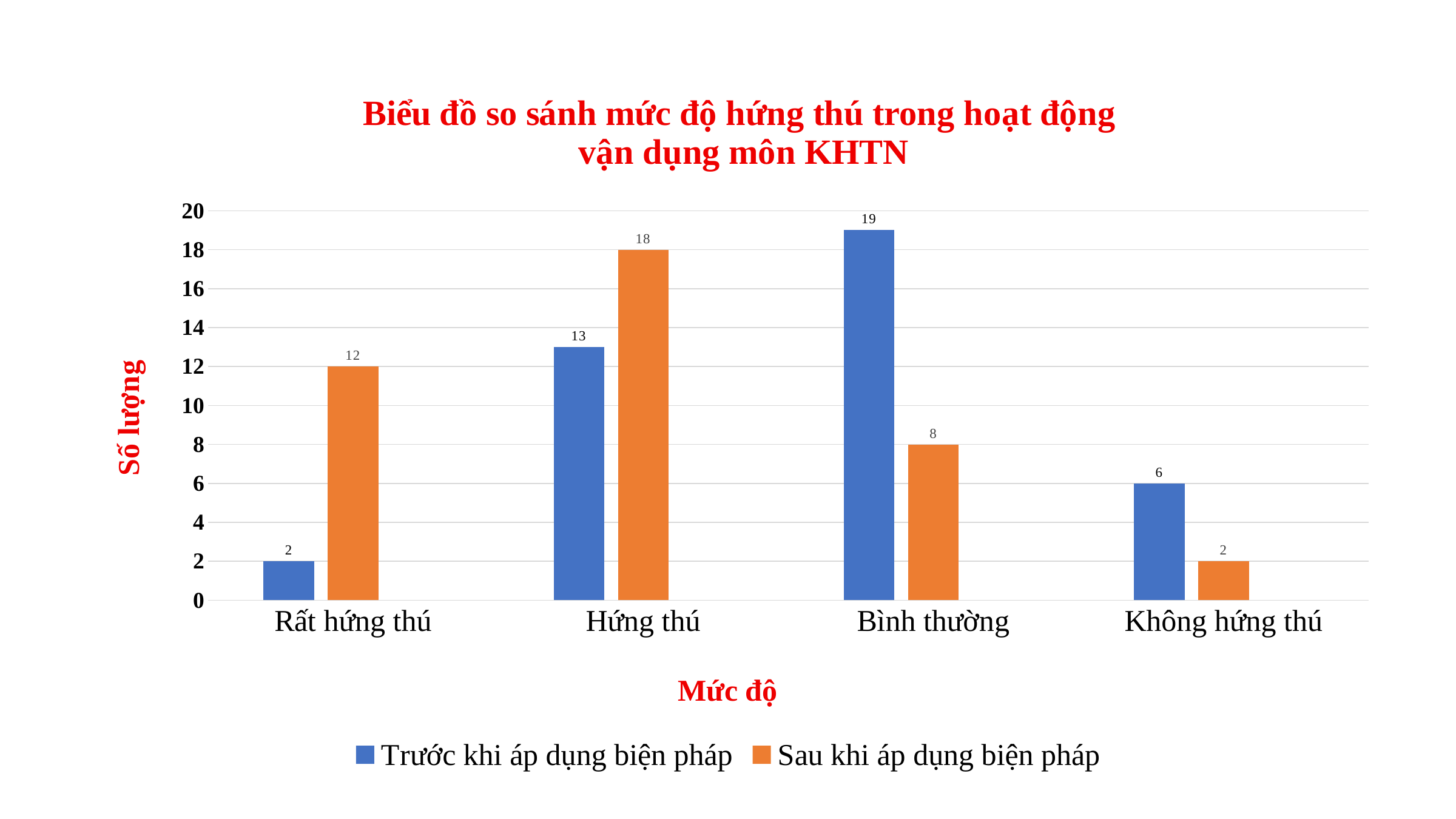
How many categories are shown on the x axis? 4 What is the value for "Rất hứng thú" in the "Trước khi áp dụng biện pháp" series? 2 How many series does the legend list? 2 For "Bình thường", which series has the larger value: "Trước khi áp dụng biện pháp" or "Sau khi áp dụng biện pháp"? Trước khi áp dụng biện pháp Which category has the highest value in the "Trước khi áp dụng biện pháp" series? Bình thường What is the label of the y axis? Số lượng What kind of chart is shown on the slide? Bar chart What is the difference between the "Sau khi áp dụng biện pháp" and "Trước khi áp dụng biện pháp" values for "Rất hứng thú"? 10 What is the value for "Không hứng thú" in the "Sau khi áp dụng biện pháp" series? 2 Which category has the lowest value in the "Sau khi áp dụng biện pháp" series? Không hứng thú What is the value for "Hứng thú" in the "Sau khi áp dụng biện pháp" series? 18 What is the value for "Bình thường" in the "Trước khi áp dụng biện pháp" series? 19